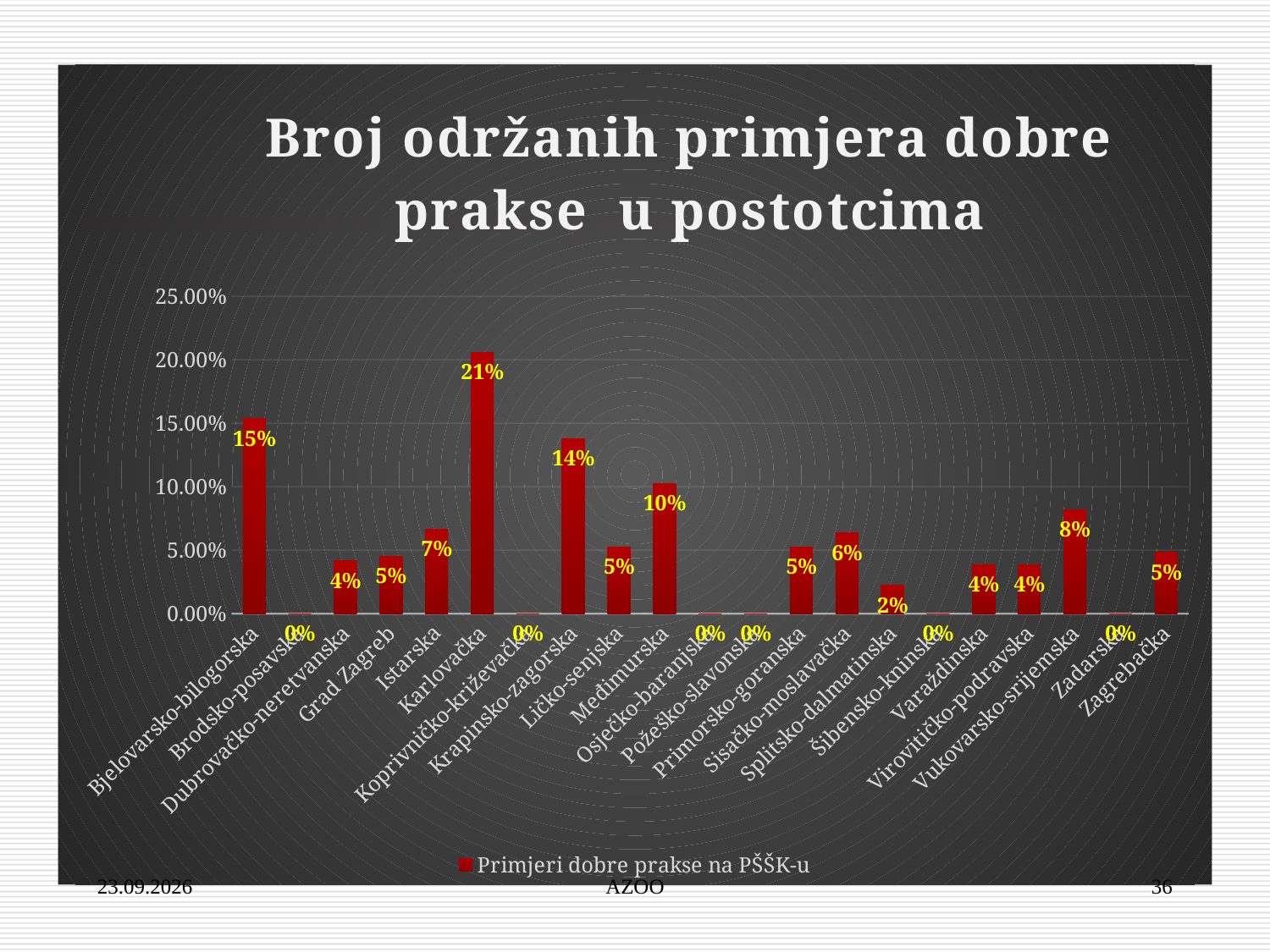
What is the value for Splitsko-dalmatinska? 2% How many categories are shown on the x axis? 21 Is the value for Karlovačka greater or less than 20.00%? greater Which is larger, the value for Krapinsko-zagorska or the value for Međimurska? Krapinsko-zagorska What is the value for Karlovačka? 21% How many series does the legend list? 1 Which category has the highest value? Karlovačka What is the legend entry for the series? Primjeri dobre prakse na PŠŠK-u What is the value for Međimurska? 10% What kind of chart is shown on the slide? bar chart What is the difference between the values for Karlovačka and Bjelovarsko-bilogorska? 6% What is the value for Vukovarsko-srijemska? 8%